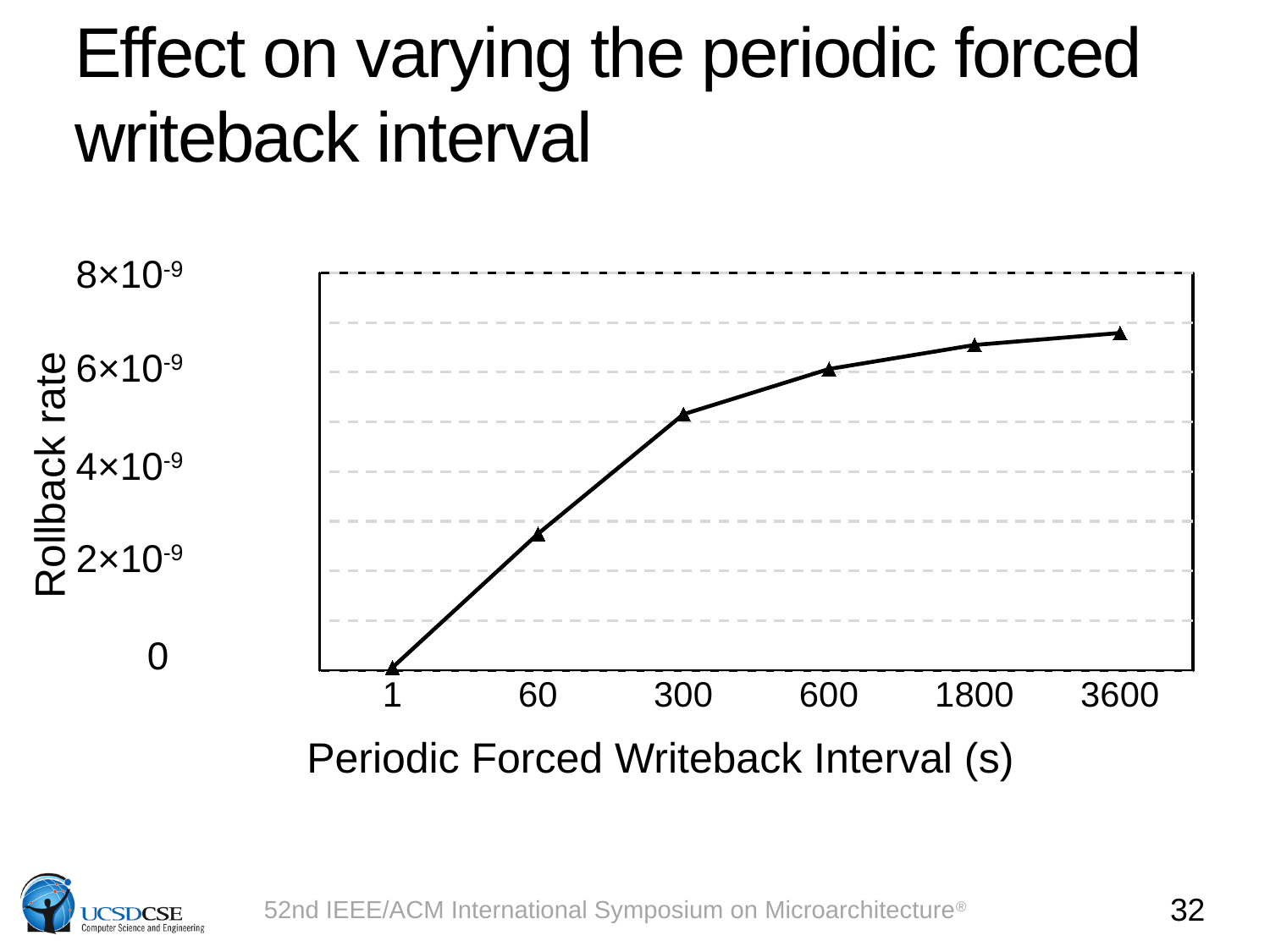
What is the label of the x axis? Periodic Forced Writeback Interval (s) How many data points are plotted on the line? 6 Is the rollback rate at an interval of 1800 s greater or less than 6×10⁻⁹? greater Is the rollback rate at an interval of 300 s greater or less than 4×10⁻⁹? greater Which periodic forced writeback interval has the lowest rollback rate? 1 What kind of chart is shown on the slide? line chart Is the rollback rate at an interval of 3600 s greater or less than 8×10⁻⁹? less Which has the larger rollback rate, an interval of 60 s or an interval of 3600 s? 3600 Which periodic forced writeback interval has the highest rollback rate? 3600 Does the rollback rate rise or fall as the periodic forced writeback interval increases along the x axis? rise